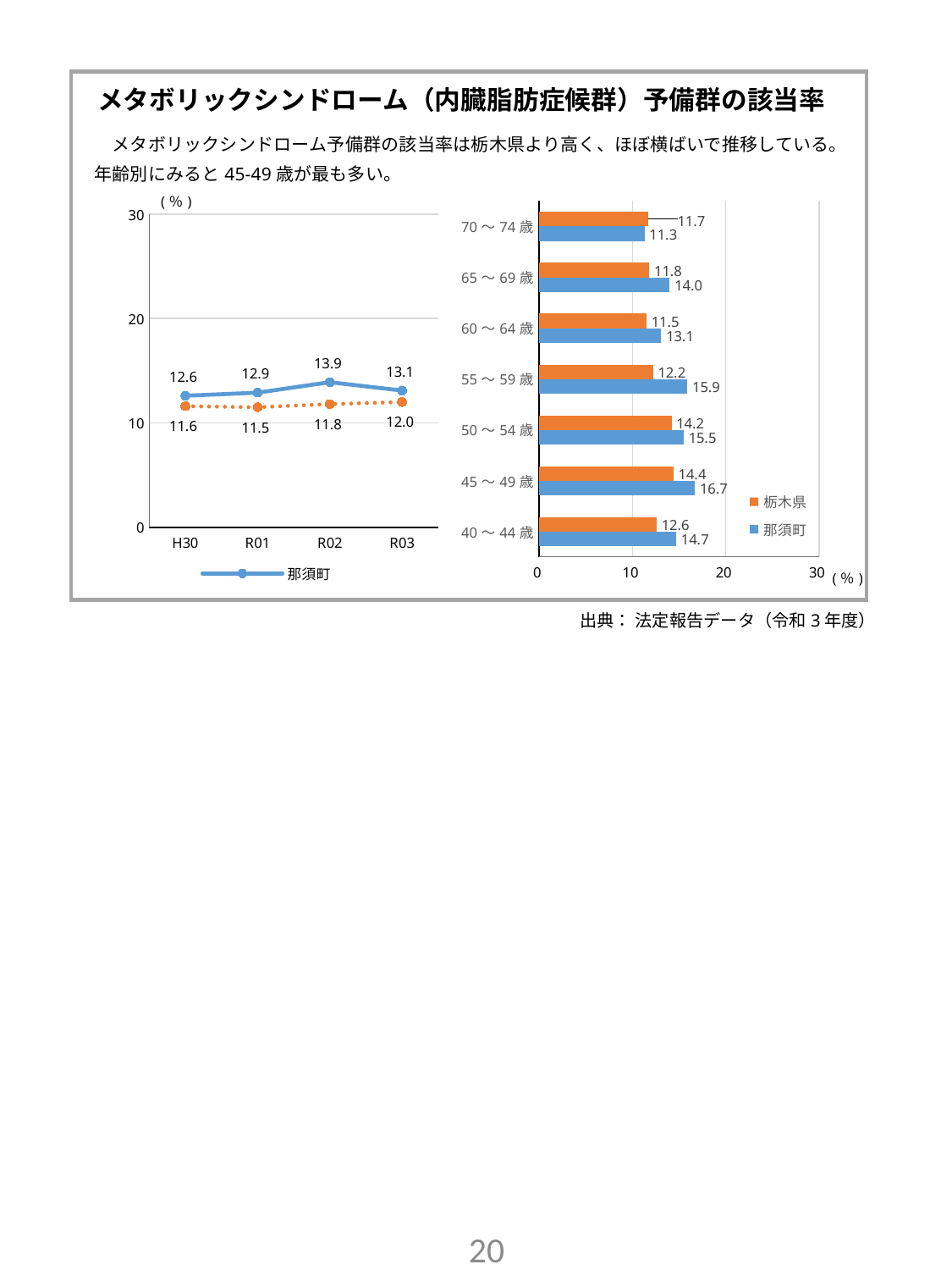
In the right bar chart, which age group has the lowest 那須町 value? 70～74歳 In the left line chart, in which year is the 那須町 value highest? R02 In the left line chart, how many years are plotted on the x axis? 4 In the right bar chart, what is the value for 那須町 in the 45～49歳 group? 16.7 In the right bar chart, how many series does the legend list? 2 In the right bar chart, what is the value for 栃木県 in the 55～59歳 group? 12.2 In the right bar chart, what is the difference between 那須町 and 栃木県 in the 55～59歳 group? 3.7 In the left line chart, what is the difference between the 那須町 values in R02 and H30? 1.3 In the left line chart, what is the value for 那須町 in R02? 13.9 What kind of chart is the chart on the right? Bar chart In the right bar chart, which is larger for the 70～74歳 group, 栃木県 or 那須町? 栃木県 In the right bar chart, which age group has the highest 那須町 value? 45～49歳